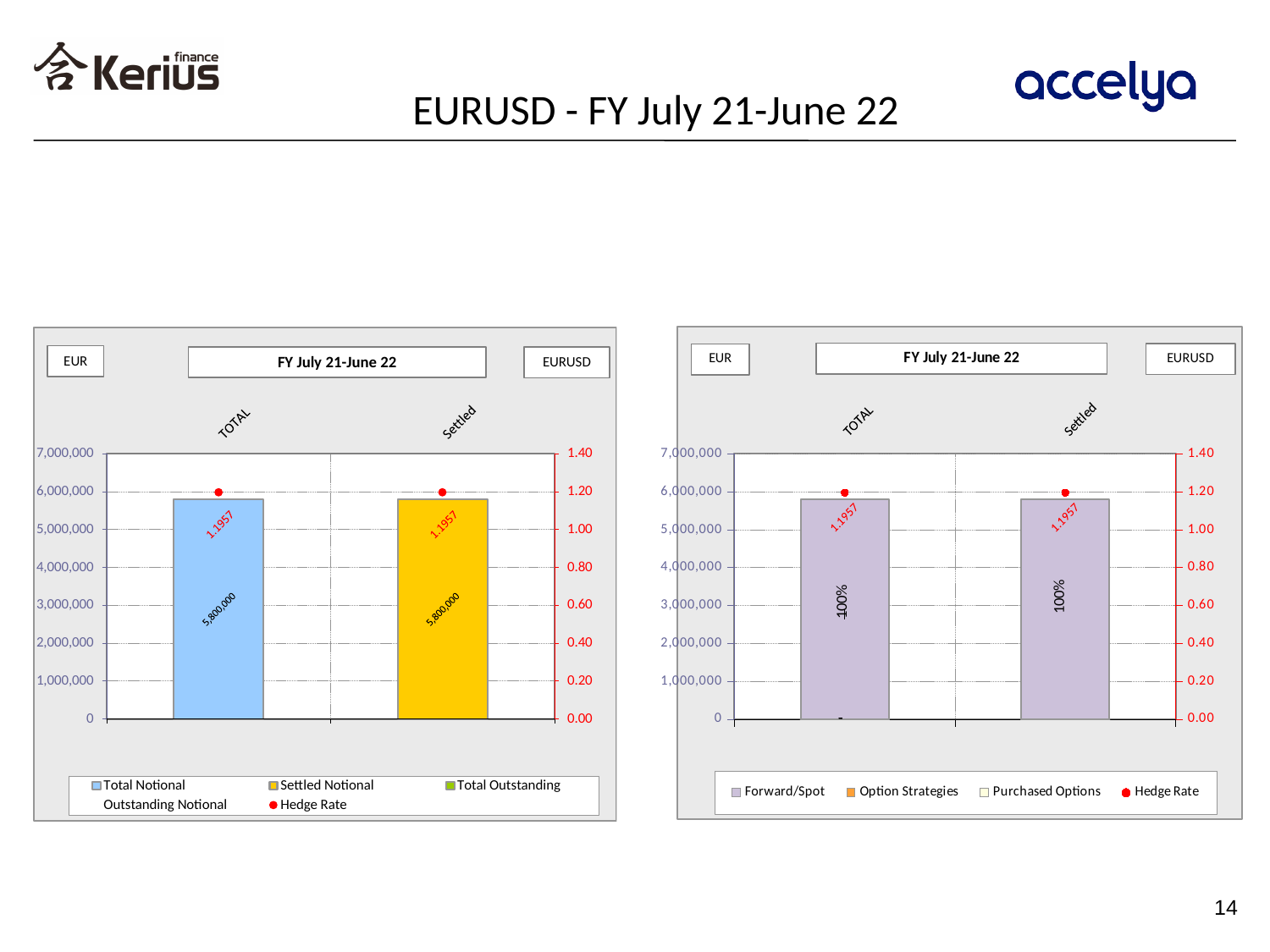
On the right chart, is the Forward/Spot bar for Settled greater or less than 6,000,000? less On the right chart, what percentage label is shown on the Forward/Spot bar for TOTAL? 100% What type of chart is the left chart? bar chart On the left chart, what is the Settled Notional value for Settled? 5,800,000 On the right chart, what is the Hedge Rate shown for Settled? 1.1957 What is the title shown inside the right chart? FY July 21-June 22 On the left chart, what is the difference between the Total Notional for TOTAL and the Settled Notional for Settled? 0 On the left chart, what is the Total Notional value for TOTAL? 5,800,000 On the left chart, is the Total Notional bar for TOTAL greater or less than 5,000,000? greater How many series does the legend of the right chart list? 4 How many categories are shown on the x axis of the left chart? 2 On the left chart, what is the Hedge Rate shown for TOTAL? 1.1957